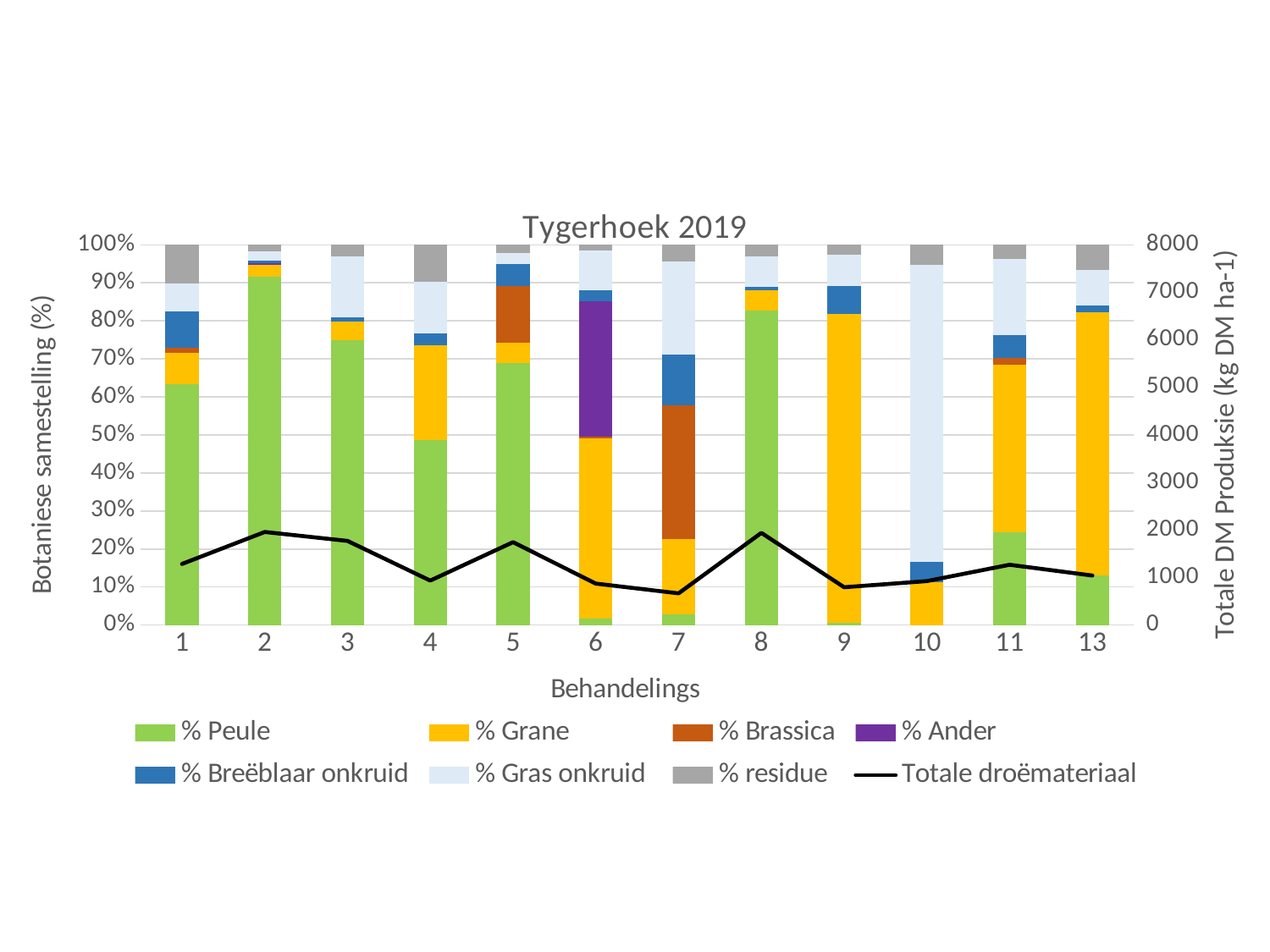
Is the % Gras onkruid for treatment 10 greater or less than 50%? greater Is the % Peule for treatment 1 greater or less than 50%? greater What kind of chart is shown on the slide? A stacked bar chart combined with a line Which treatment has a larger % Brassica, treatment 5 or treatment 7? 7 Which treatment has the highest % Peule? 2 What is the title of the chart? Tygerhoek 2019 Is the Totale droëmateriaal for treatment 2 greater or less than 1000 kg DM ha-1? greater How many treatments (Behandelings) are shown on the x axis? 12 How many series does the legend list? 8 Which treatment has a larger % Grane, treatment 1 or treatment 9? 9